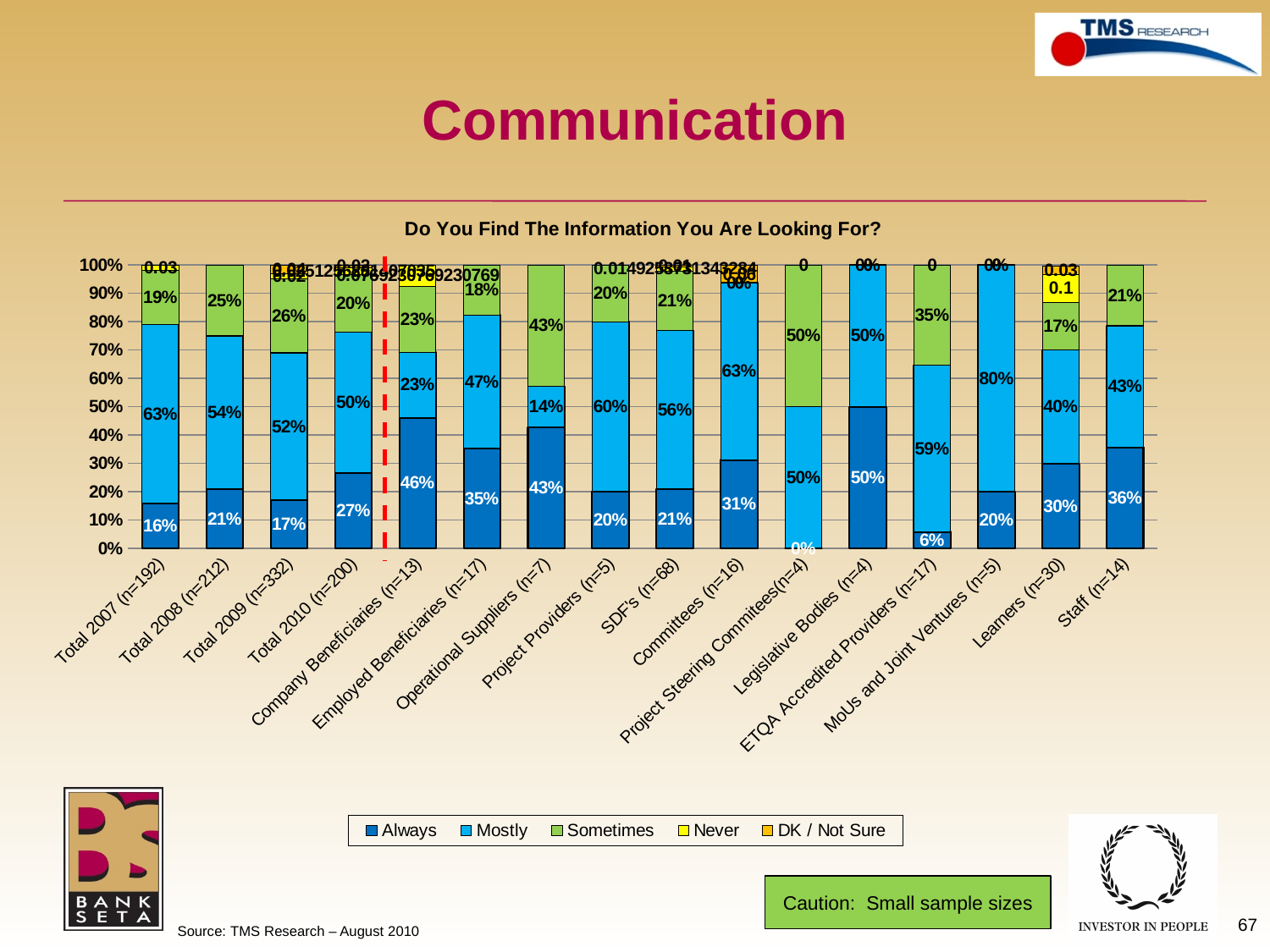
What kind of chart is shown on the slide? Stacked bar chart How many categories are shown along the x axis? 16 What is the difference between the 'Mostly' values for Total 2007 (n=192) and Total 2010 (n=200)? 13 percentage points What is the 'Mostly' value for MoUs and Joint Ventures (n=5)? 80% What is the title of the chart? Do You Find The Information You Are Looking For? Which has a larger 'Always' value, Staff (n=14) or Learners (n=30)? Staff (n=14) Which category has the lowest 'Always' value? Project Steering Committees (n=4) How many series does the legend list? 5 What is the 'Sometimes' value for Operational Suppliers (n=7)? 43% Which category has the highest 'Always' value? Legislative Bodies (n=4) What is the 'Always' value for ETQA Accredited Providers (n=17)? 6% What is the 'Always' value for Total 2007 (n=192)? 16%